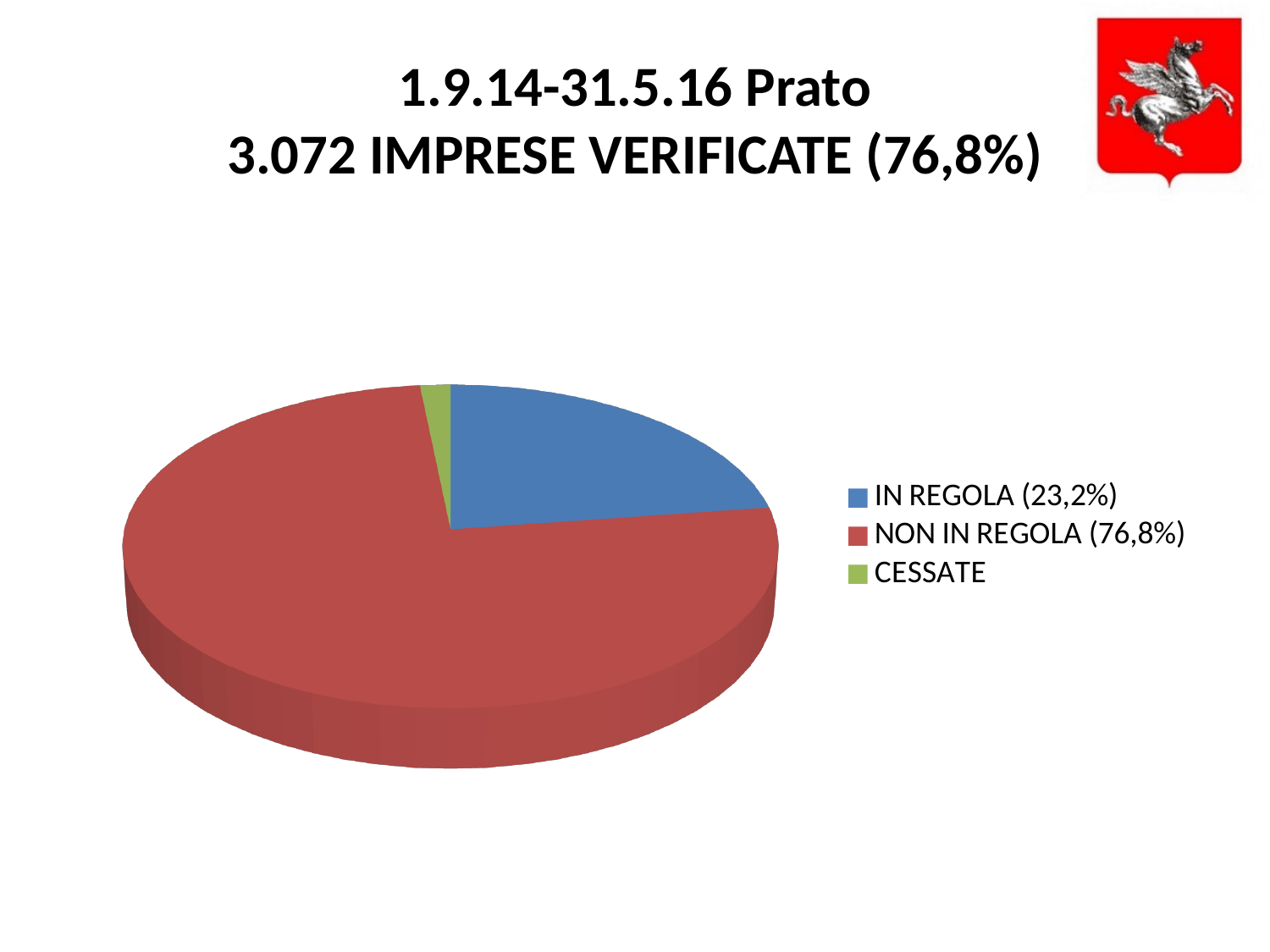
How many entries does the legend of the pie chart list? 3 Which slice is larger, IN REGOLA or CESSATE? IN REGOLA What kind of chart is shown on the slide? pie chart What share of the pie does NON IN REGOLA represent, according to the legend? 76,8% Which category has the largest slice of the pie chart? NON IN REGOLA What share of the pie does IN REGOLA represent, according to the legend? 23,2% How many slices does the pie chart have? 3 How many IMPRESE VERIFICATE does the slide title report for Prato? 3.072 What colour is the NON IN REGOLA slice in the pie chart? red By how many percentage points does the NON IN REGOLA share exceed the IN REGOLA share? 53,6 Which category has the smallest slice of the pie chart? CESSATE